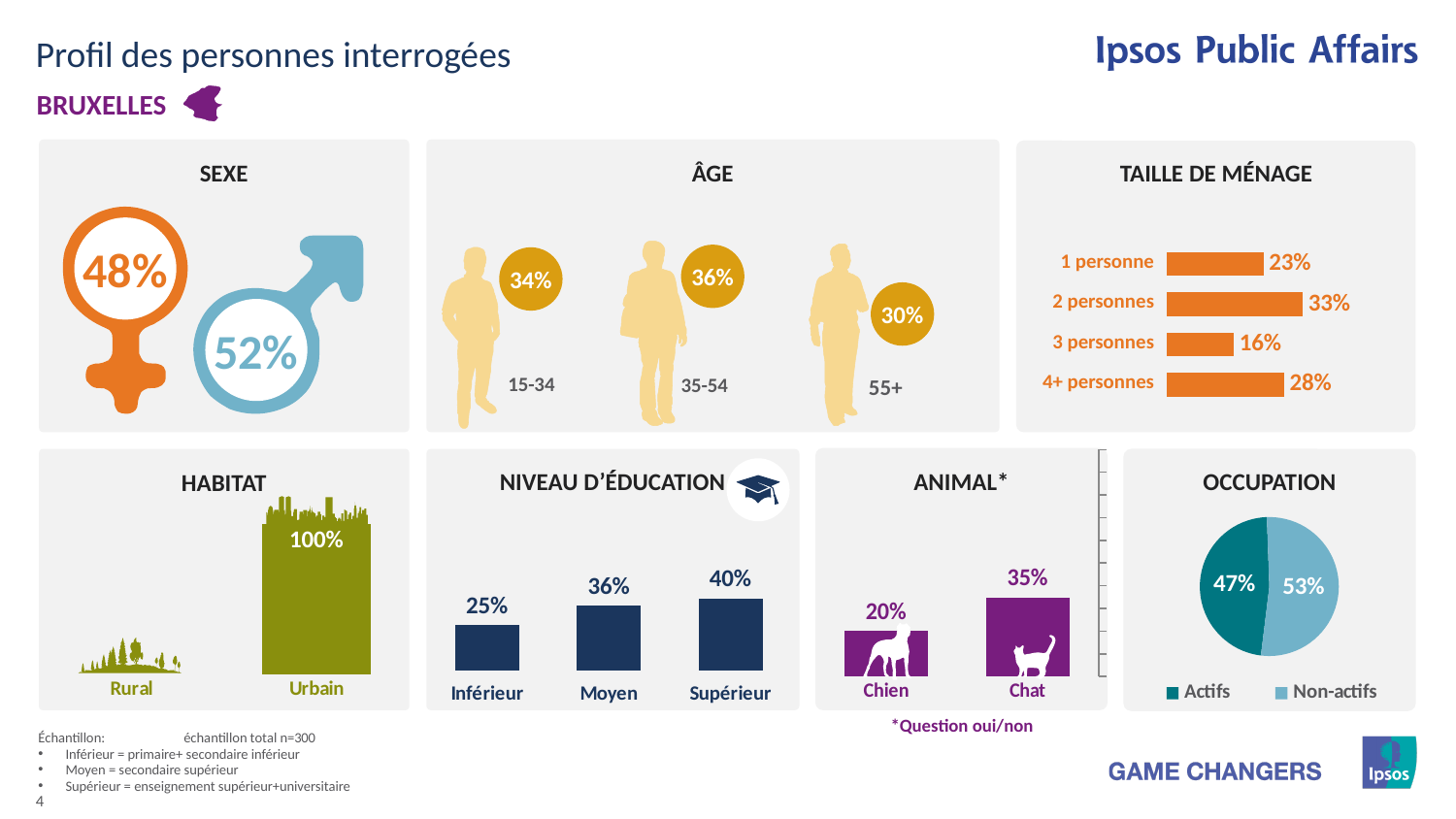
What kind of chart is the OCCUPATION chart? pie chart In the NIVEAU D'ÉDUCATION chart, which education level has the highest value? Supérieur In the TAILLE DE MÉNAGE chart, what is the difference between 4+ personnes and 1 personne? 5% In the NIVEAU D'ÉDUCATION chart, what is the value for Moyen? 36% In the ANIMAL chart, which is larger, Chien or Chat? Chat In the TAILLE DE MÉNAGE chart, what is the value for 2 personnes? 33% In the OCCUPATION chart, how many series does the legend list? 2 In the TAILLE DE MÉNAGE chart, which household size has the lowest value? 3 personnes In the OCCUPATION chart, what share of the pie is Actifs? 47% In the NIVEAU D'ÉDUCATION chart, do the values rise or fall from Inférieur to Supérieur? rise In the TAILLE DE MÉNAGE chart, how many household size categories are shown? 4 In the ANIMAL chart, what is the difference between Chat and Chien? 15%